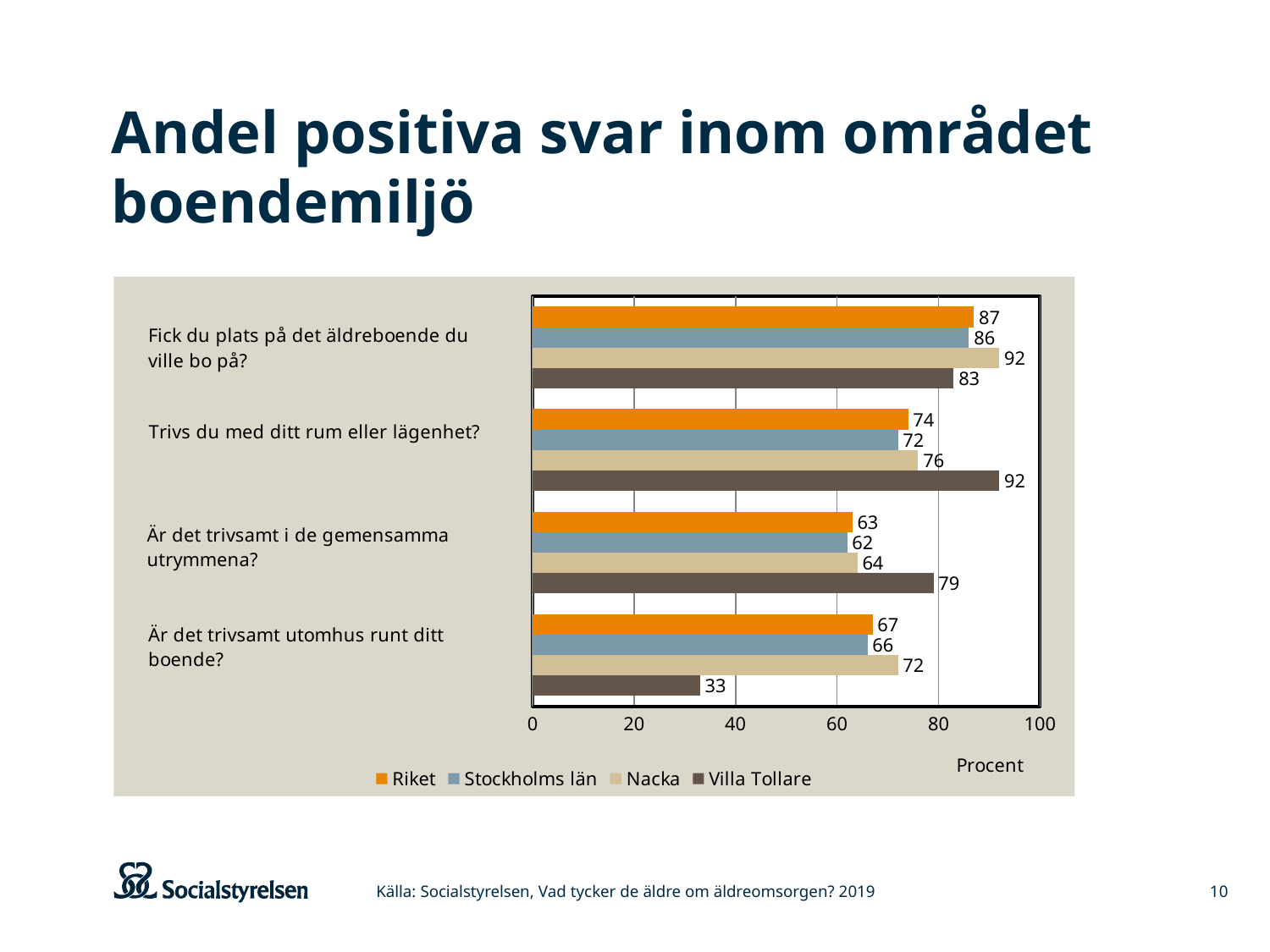
What is the value for Nacka on "Fick du plats på det äldreboende du ville bo på?"? 92 What is the value for Villa Tollare on "Är det trivsamt utomhus runt ditt boende?"? 33 Which series has the lowest value for "Är det trivsamt utomhus runt ditt boende?"? Villa Tollare How many series does the legend list? 4 Is the value for Nacka on "Är det trivsamt utomhus runt ditt boende?" greater or less than 60? greater What kind of chart is shown on the slide? Bar chart What is the value for Stockholms län on "Är det trivsamt i de gemensamma utrymmena?"? 62 Which series has the highest value for "Trivs du med ditt rum eller lägenhet?"? Villa Tollare Which is larger for "Fick du plats på det äldreboende du ville bo på?": Riket or Villa Tollare? Riket How many questions (categories) are shown on the chart? 4 What is the value for Riket on "Trivs du med ditt rum eller lägenhet?"? 74 What is the difference between Villa Tollare and Riket on "Är det trivsamt i de gemensamma utrymmena?"? 16